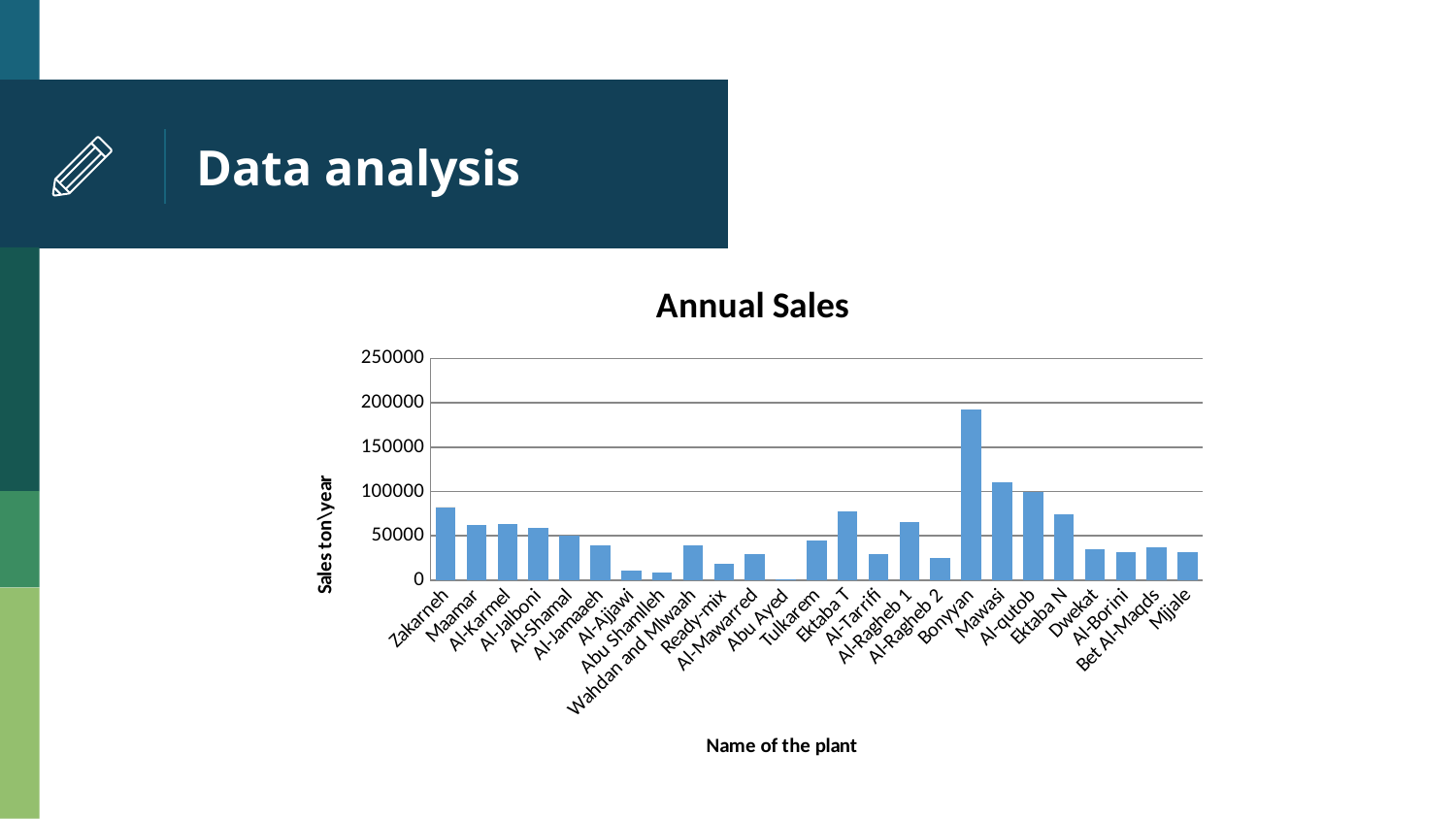
Is the value for Mawasi greater or less than 100000? greater Which plant has the highest annual sales? Bonyyan Which has higher annual sales, Ektaba T or Al-Tarrifi? Ektaba T How many plants are shown on the x axis of the chart? 25 Which has higher annual sales, Bonyyan or Mawasi? Bonyyan What is the label of the vertical axis? Sales ton\year Is the value for Bonyyan greater or less than 150000? greater Which has higher annual sales, Zakarneh or Maamar? Zakarneh What is the title of the chart? Annual Sales What kind of chart is shown on the slide? bar chart Is the value for Al-Ajjawi greater or less than 50000? less